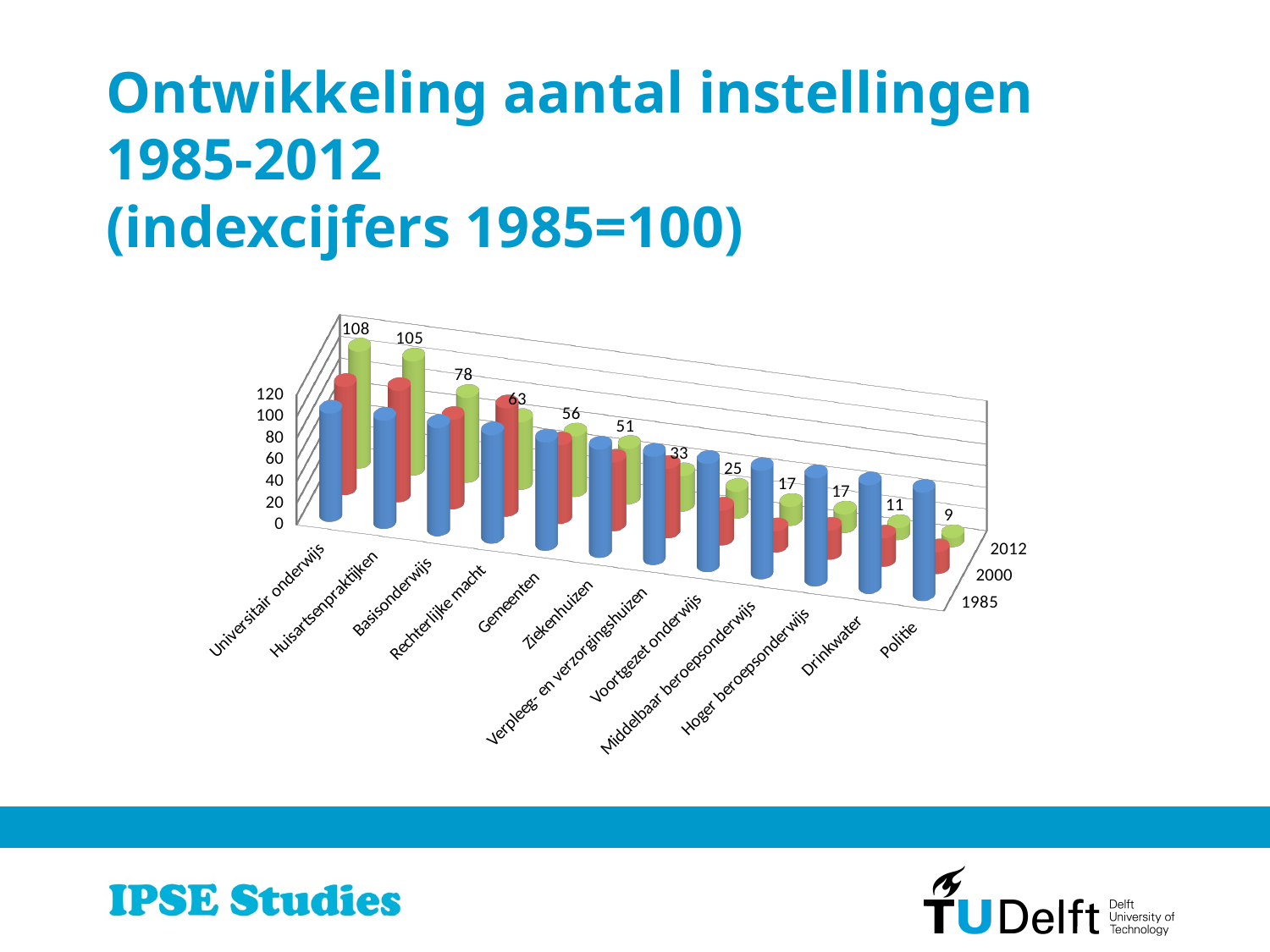
What is the difference between the 2012 index values for Huisartsenpraktijken and Basisonderwijs? 27 Which category has the lowest 2012 index value? Politie How many series (years) does the chart show? 3 Do the 2012 index values rise or fall from left to right across the categories? fall How many categories are shown on the chart? 12 What is the 2012 index value for Drinkwater? 11 Is the 2000 index value for Politie greater or less than 60? less What is the 2012 index value for Universitair onderwijs? 108 Which category has the highest 2012 index value? Universitair onderwijs Which has the larger 2012 index value, Gemeenten or Ziekenhuizen? Gemeenten What kind of chart is shown on the slide? bar chart What is the 2012 index value for Politie? 9